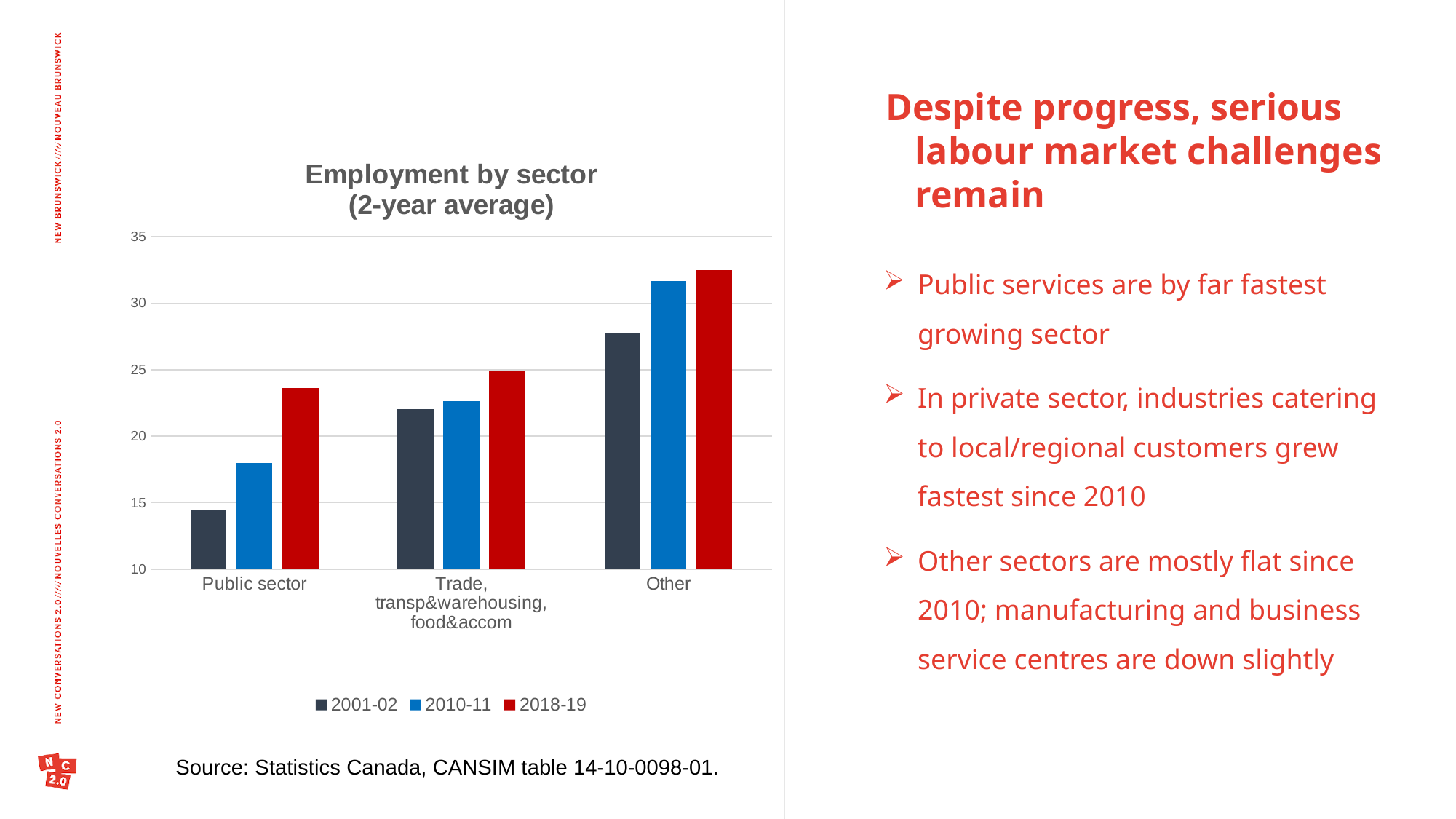
Which sector has the highest 2018-19 value in the chart? Other Is the 2001-02 value for Public sector greater or less than 15? less For Public sector, which is larger: the 2010-11 value or the 2018-19 value? 2018-19 Which sector has the lowest 2001-02 value in the chart? Public sector How many series does the legend of the chart list? 3 What is the title of the chart? Employment by sector (2-year average) Is the 2010-11 value for Other greater or less than 30? greater For Public sector, do the values rise or fall from 2001-02 to 2018-19? rise How many sectors (categories) are shown on the x axis of the chart? 3 Is the 2001-02 value for Other greater or less than 25? greater What kind of chart is shown on the slide? bar chart